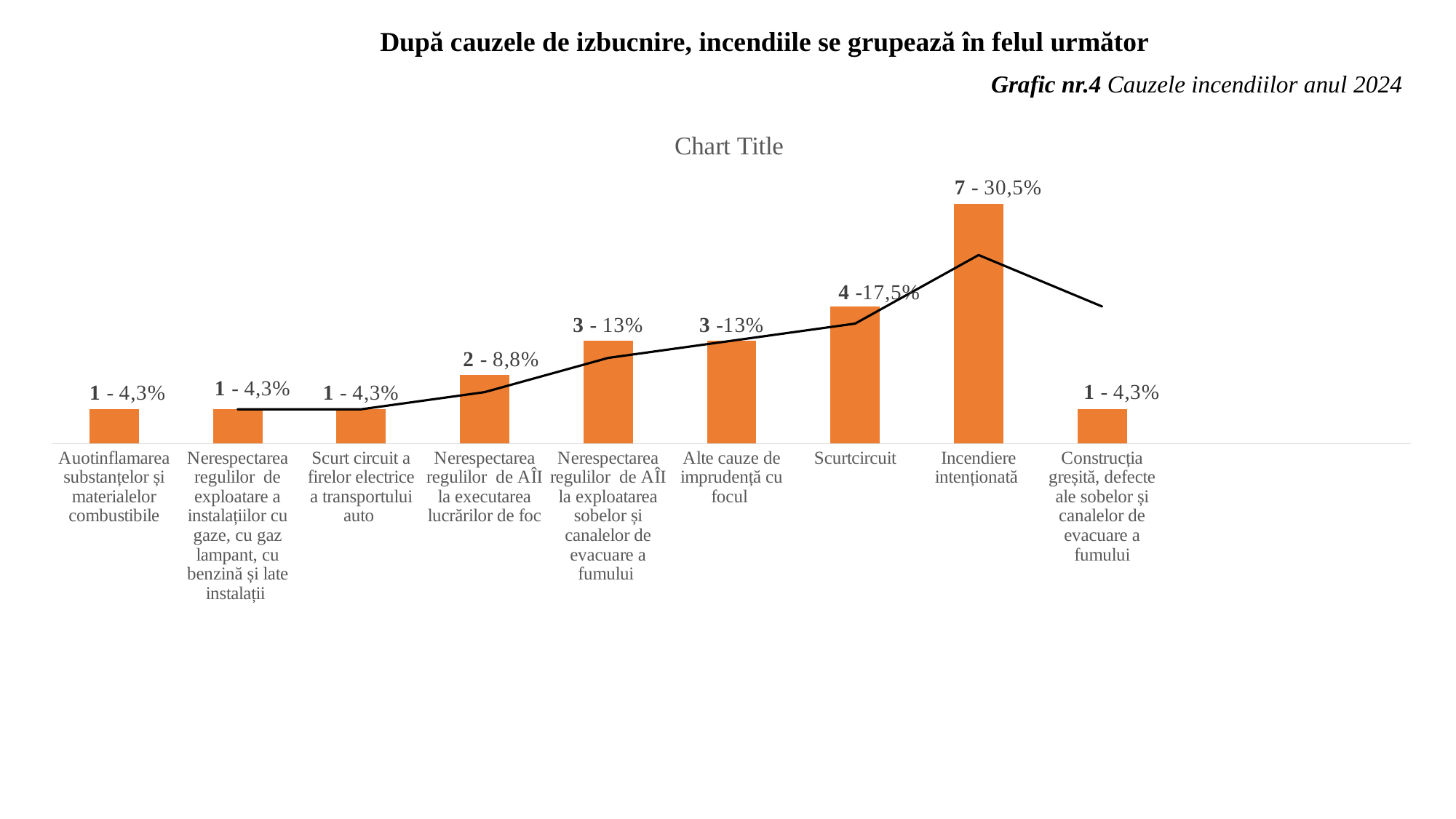
Which category has the highest value in the chart? Incendiere intenționată What colour are the bars in the chart? orange How many categories have a count of 1 in the chart? 4 What is the title printed above the chart area? Chart Title What is the data label for the 'Nerespectarea regulilor de AÎI la executarea lucrărilor de foc' bar? 2 - 8,8% What is the data label for the 'Alte cauze de imprudență cu focul' bar? 3 -13% What kind of chart is shown on the slide? bar chart What is the data label for the 'Incendiere intenționată' bar? 7 - 30,5% How many categories are plotted on the x axis of the chart? 9 Which is larger: the value for 'Scurtcircuit' or the value for 'Alte cauze de imprudență cu focul'? Scurtcircuit What is the data label for the 'Scurtcircuit' bar? 4 -17,5% What is the difference in count between 'Incendiere intenționată' and 'Scurtcircuit'? 3